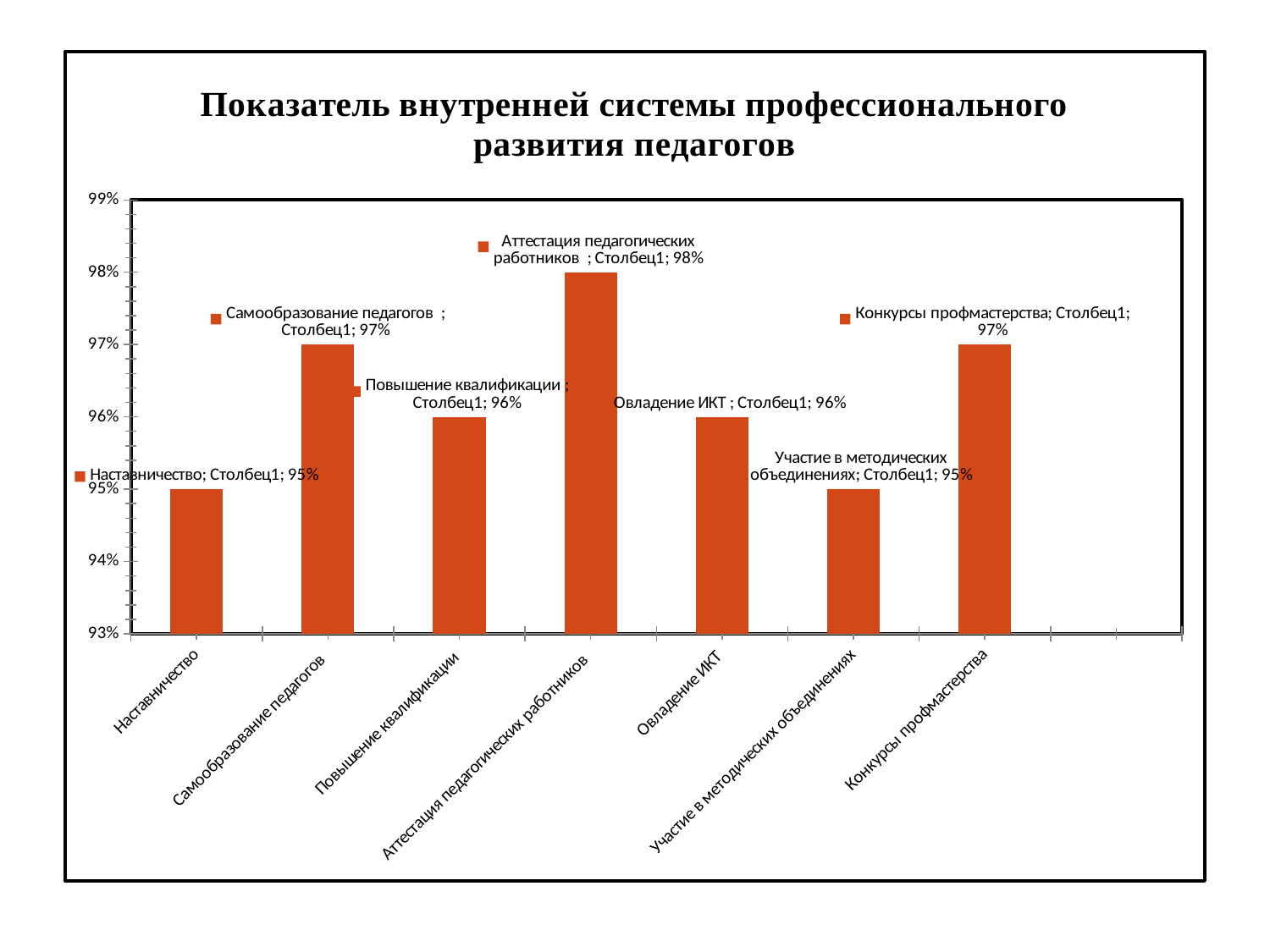
How many categories are shown on the x axis? 7 What is the value for Овладение ИКТ? 96% What is the difference between the values for Аттестация педагогических работников and Наставничество? 3% What kind of chart is shown on the slide? bar chart Is the value for Участие в методических объединениях greater or less than 96%? less What is the value for Аттестация педагогических работников? 98% What is the difference between the values for Конкурсы профмастерства and Овладение ИКТ? 1% Which category has the highest value? Аттестация педагогических работников What is the title of the chart? Показатель внутренней системы профессионального развития педагогов What is the value for Наставничество? 95% Which is larger, the value for Самообразование педагогов or the value for Повышение квалификации? Самообразование педагогов What is the value for Конкурсы профмастерства? 97%